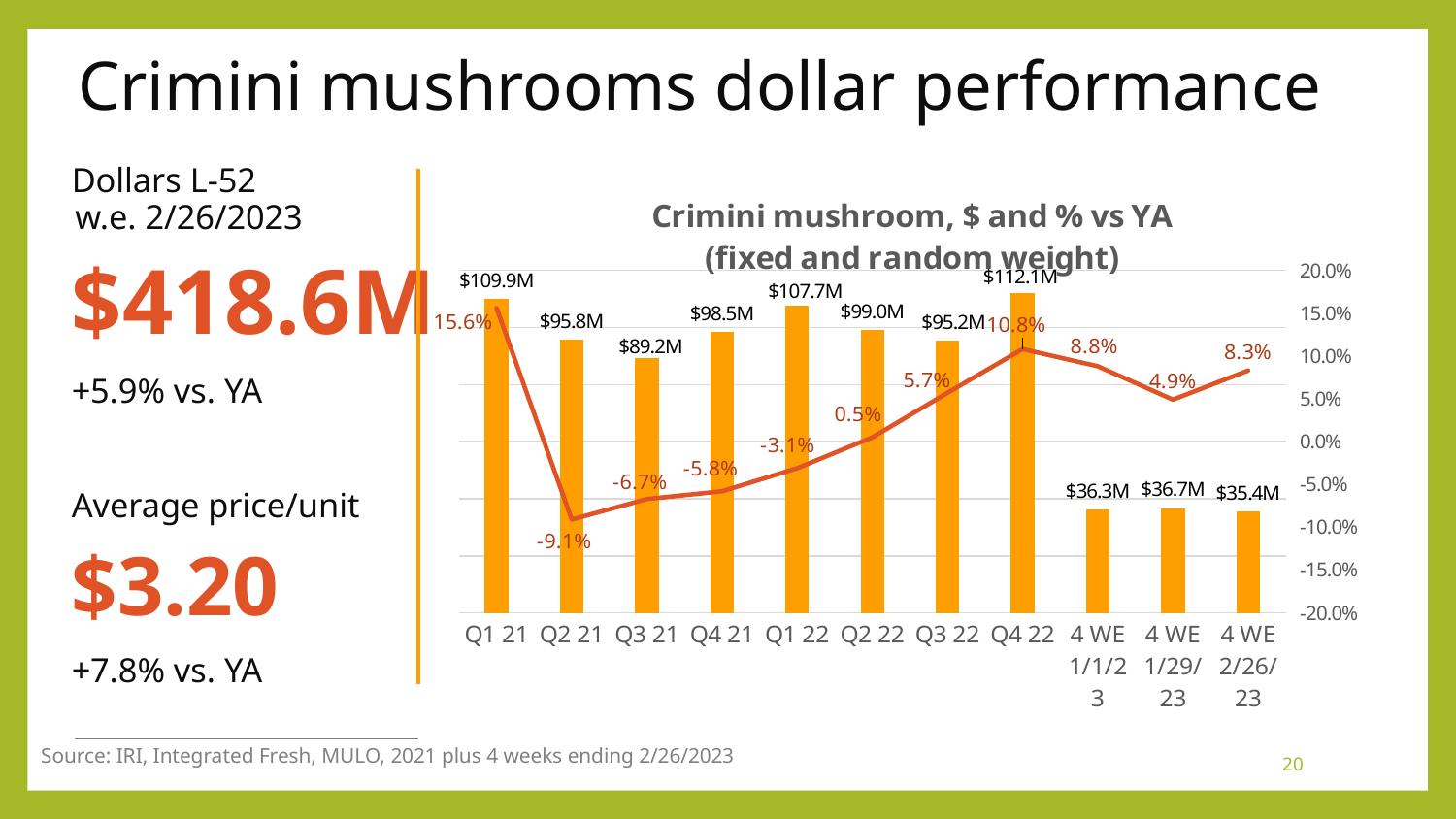
Does the % vs YA line rise or fall from Q2 21 to Q4 22? Rise What is the dollar value for Q4 22? $112.1M Which is larger, the dollar value for Q1 22 or Q2 22? Q1 22 What is the % vs YA value for Q2 21? -9.1% Which quarter has the highest dollar value? Q4 22 What is the dollar value for the 4 WE 2/26/23 period? $35.4M Is the % vs YA value for Q4 22 greater or less than 10.0%? greater What is the difference in dollars between Q1 21 and Q3 21? $20.7M How many periods are shown on the x axis? 11 Which period has the lowest % vs YA value? Q2 21 What is the title of the chart? Crimini mushroom, $ and % vs YA (fixed and random weight) What kind of chart is this? Combination bar and line chart